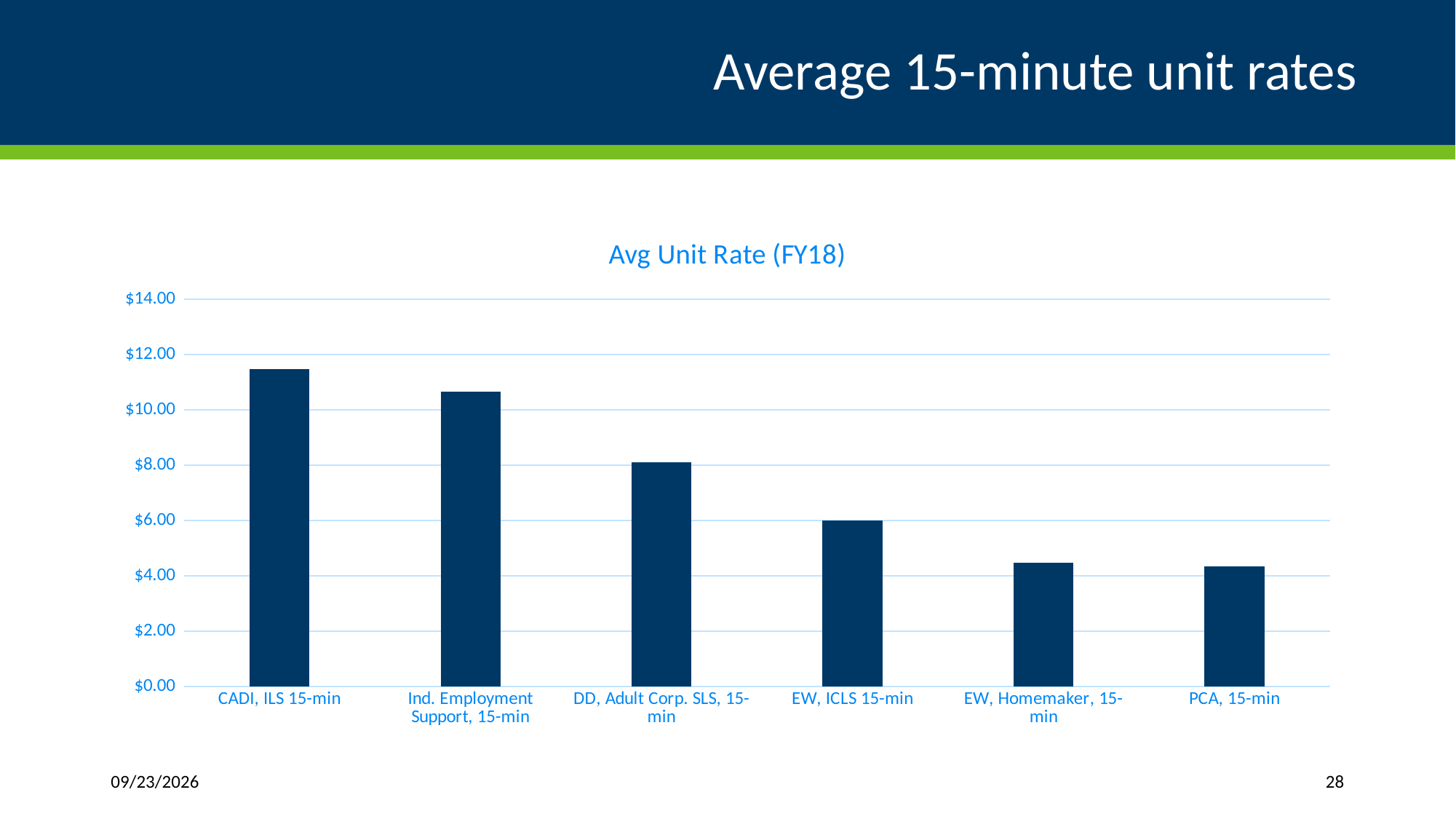
Is the value for Ind. Employment Support, 15-min greater or less than $12.00? less Is the value for CADI, ILS 15-min greater or less than $10.00? greater What type of chart is shown on the slide? bar chart Do the values generally rise or fall moving from left to right along the x axis? fall Is the value for EW, Homemaker, 15-min greater or less than $4.00? greater Which is larger, the value for CADI, ILS 15-min or the value for Ind. Employment Support, 15-min? CADI, ILS 15-min Which is larger, the value for DD, Adult Corp. SLS, 15-min or the value for EW, ICLS 15-min? DD, Adult Corp. SLS, 15-min How many categories are plotted in the chart? 6 Which category has the highest average unit rate? CADI, ILS 15-min What is the title of the chart? Avg Unit Rate (FY18)